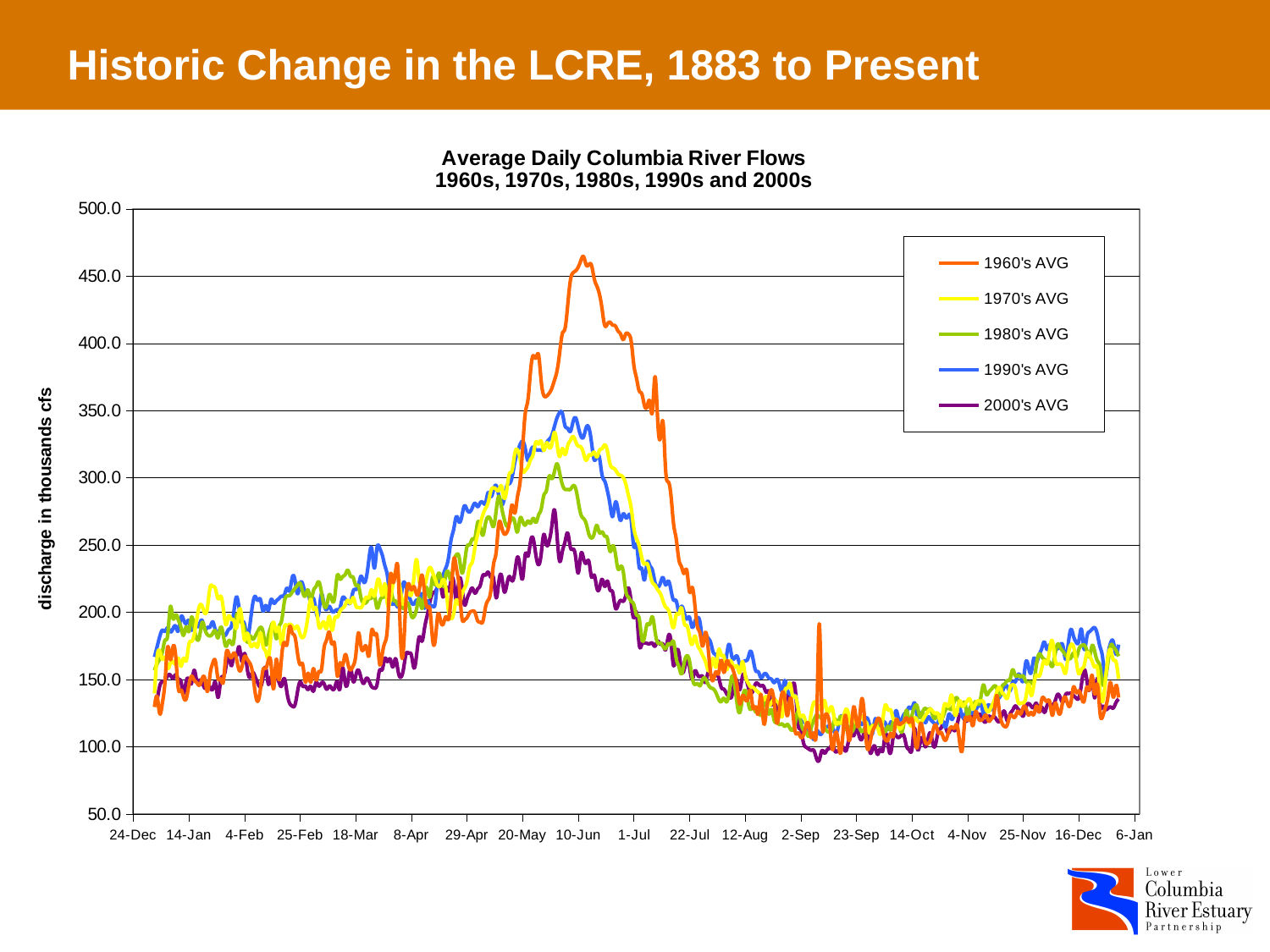
What is the label on the vertical axis? discharge in thousands cfs Which series reaches the highest peak value? 1960's AVG How many series does the legend list? 5 What is the title of the chart? Average Daily Columbia River Flows 1960s, 1970s, 1980s, 1990s and 2000s Is the peak value of the 1960's AVG series greater or less than 450.0? greater Does the 1990's AVG series rise or fall between 29-Apr and 10-Jun? rise Is the peak value of the 2000's AVG series greater or less than 300.0? less Which series has the lowest peak value? 2000's AVG Does the 1960's AVG series rise or fall between 10-Jun and 22-Jul? fall Which series has the higher peak, 1960's AVG or 2000's AVG? 1960's AVG What kind of chart is shown on the slide? line chart Is the peak value of the 1990's AVG series greater or less than 400.0? less